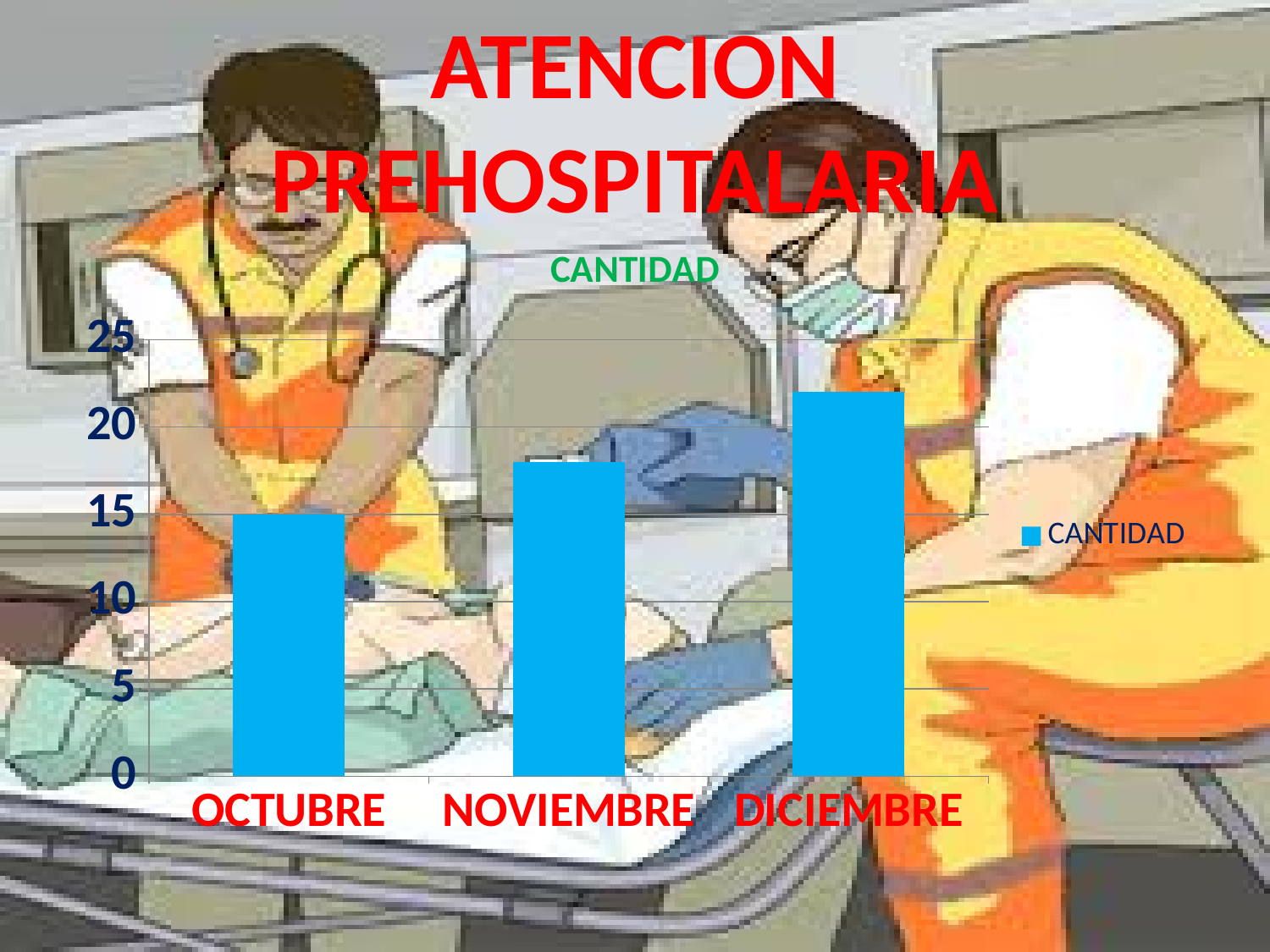
How many series does the chart's legend list? 1 Is the value for NOVIEMBRE greater or less than 20? less What kind of chart is shown on the slide? bar chart Is the value for DICIEMBRE greater or less than 25? less What is the title of the chart? CANTIDAD Which month has the lowest value in the chart? OCTUBRE Which month has the highest value in the chart? DICIEMBRE Is the value for NOVIEMBRE greater or less than 15? greater Do the values rise or fall from OCTUBRE to DICIEMBRE? rise Which is larger, the value for NOVIEMBRE or the value for DICIEMBRE? DICIEMBRE How many categories are shown on the x axis of the chart? 3